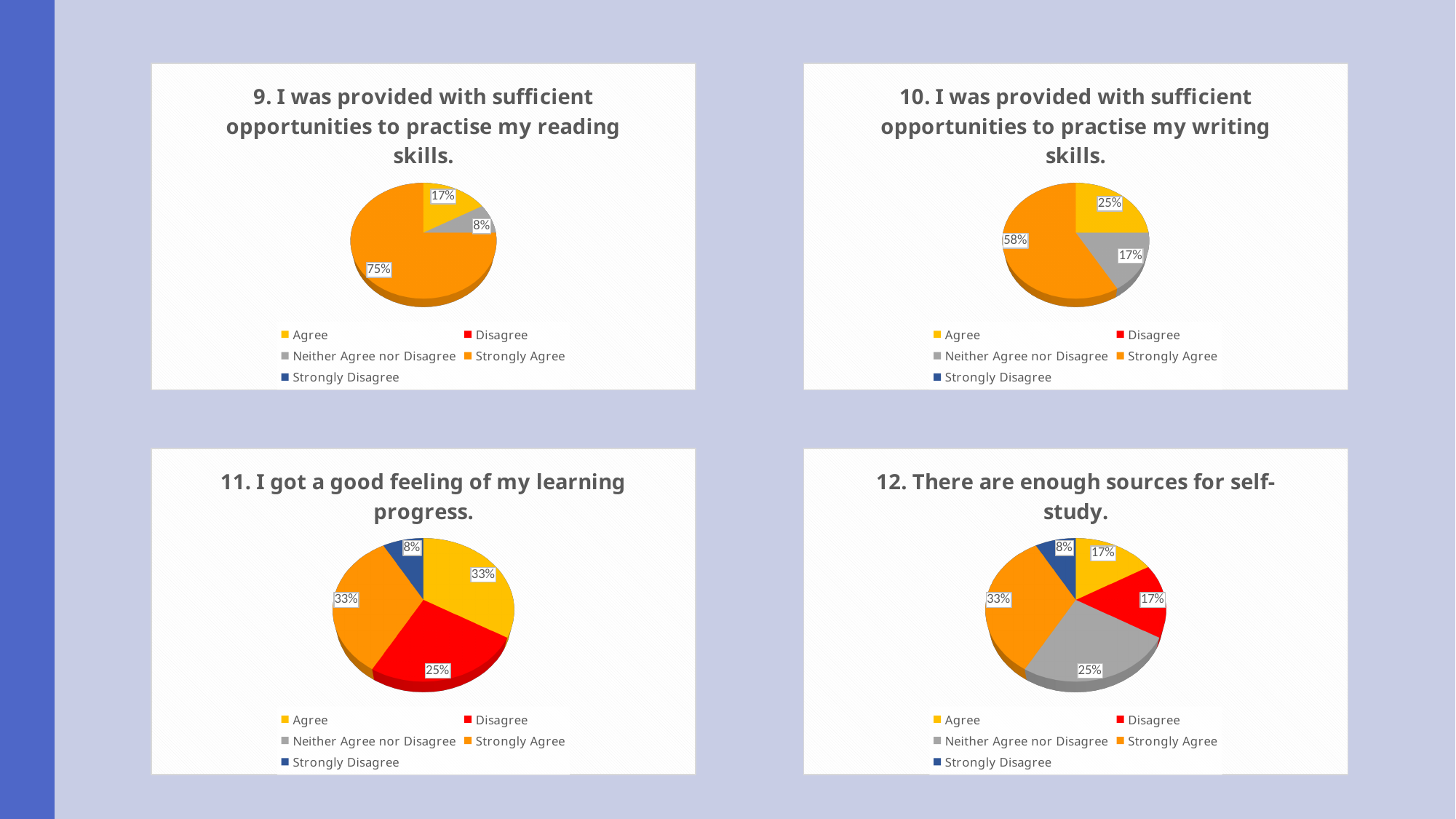
What kind of chart is used for "9. I was provided with sufficient opportunities to practise my reading skills."? Pie chart In the chart titled "12. There are enough sources for self-study.", what is the value for Neither Agree nor Disagree? 25% In the chart titled "9. I was provided with sufficient opportunities to practise my reading skills.", what is the value for Neither Agree nor Disagree? 8% In the chart titled "10. I was provided with sufficient opportunities to practise my writing skills.", which category has the largest slice? Strongly Agree In the chart titled "11. I got a good feeling of my learning progress.", which category has the smallest slice? Strongly Disagree In the chart titled "11. I got a good feeling of my learning progress.", what is the value for Disagree? 25% In the chart titled "10. I was provided with sufficient opportunities to practise my writing skills.", what is the value for Agree? 25% In the chart titled "10. I was provided with sufficient opportunities to practise my writing skills.", what is the difference between Strongly Agree and Neither Agree nor Disagree? 41% In the chart titled "12. There are enough sources for self-study.", how many slices does the pie have? 5 In the chart titled "11. I got a good feeling of my learning progress.", which is larger, Agree or Disagree? Agree In the chart titled "9. I was provided with sufficient opportunities to practise my reading skills.", what share of the pie is Strongly Agree? 75% In the chart titled "12. There are enough sources for self-study.", which category has the largest slice? Strongly Agree